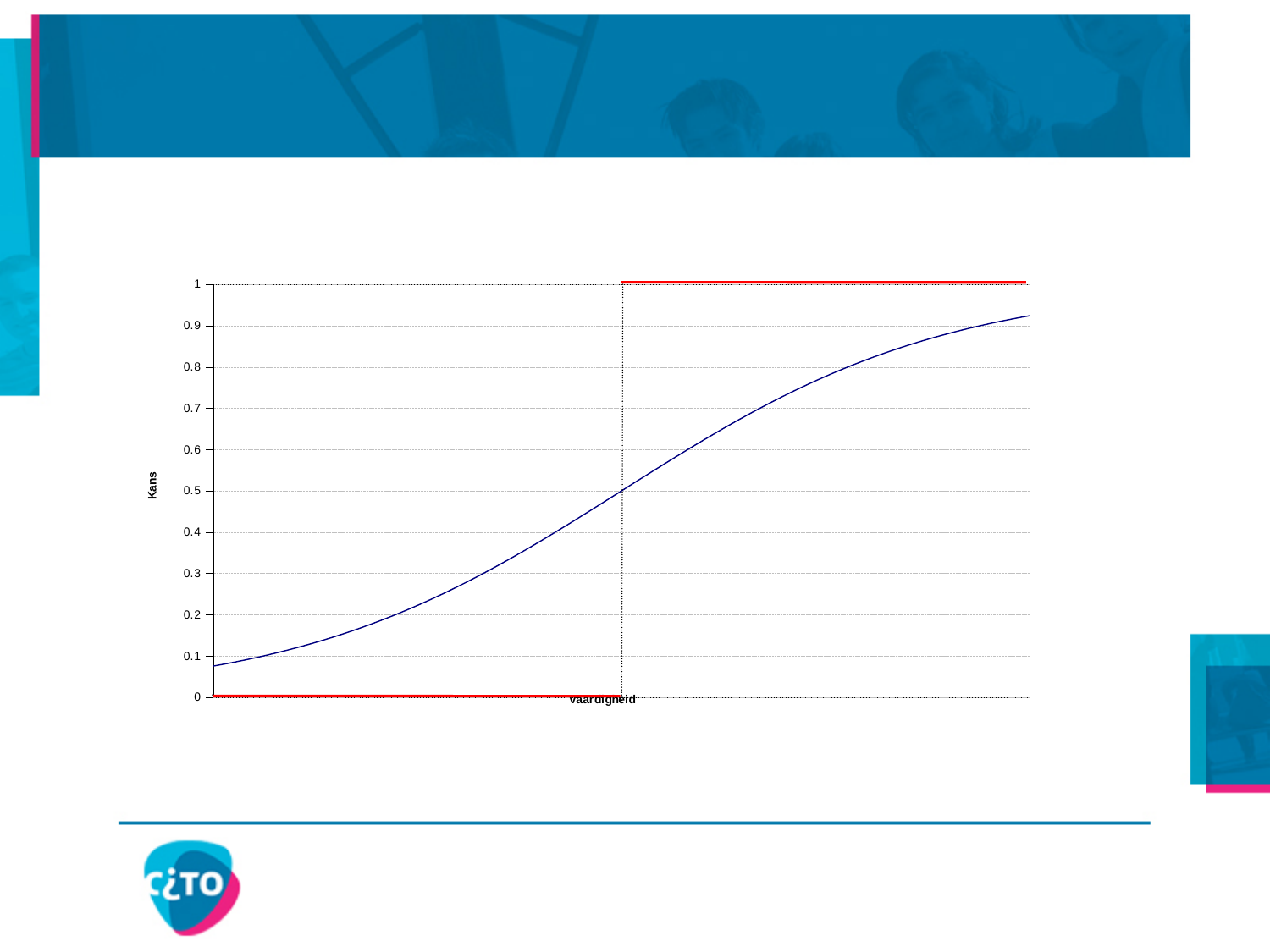
What kind of chart is shown on the slide? line chart Is the value of the blue curve at the dotted vertical line greater or less than 0.6? less Is the value of the blue curve at the right edge of the chart greater or less than 0.9? greater Is the value of the blue curve at the left edge of the chart greater or less than 0.1? less Does the blue curve rise or fall as you move from left to right along the x axis? rise What is the highest tick value shown on the vertical axis? 1 What is the label of the horizontal axis? vaardigheid Which is larger: the value of the blue curve at the left edge of the chart or at the right edge? right edge What is the label of the vertical axis? Kans